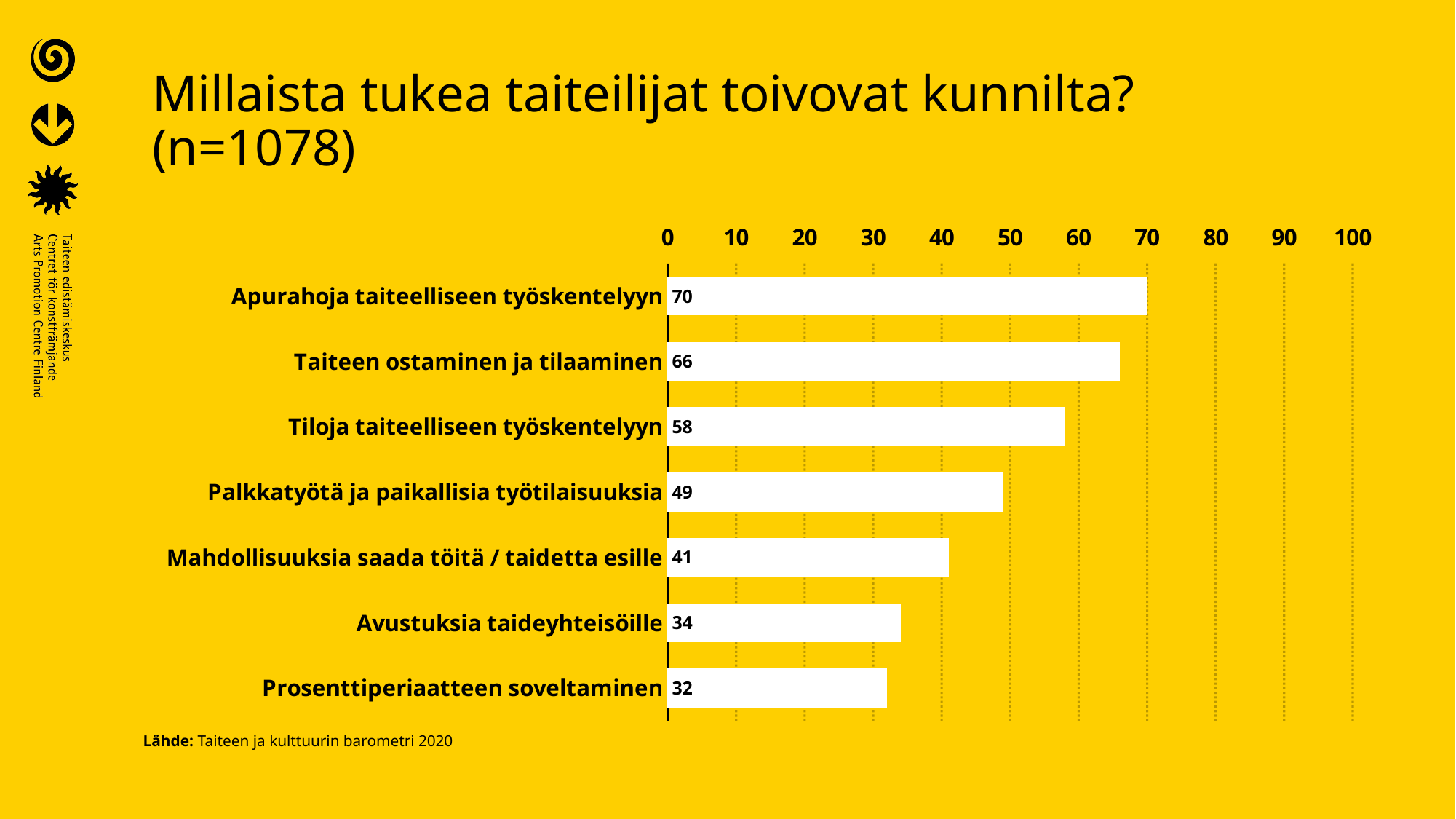
What is the value for "Avustuksia taideyhteisöille"? 34 Which category has the lowest value? Prosenttiperiaatteen soveltaminen What is the value for "Tiloja taiteelliseen työskentelyyn"? 58 Is the value for "Tiloja taiteelliseen työskentelyyn" greater or less than 50? greater What is the title of the slide? Millaista tukea taiteilijat toivovat kunnilta? (n=1078) What kind of chart is shown on the slide? bar chart What is the value for "Apurahoja taiteelliseen työskentelyyn"? 70 Which category has the highest value? Apurahoja taiteelliseen työskentelyyn What is the difference between the values for "Taiteen ostaminen ja tilaaminen" and "Palkkatyötä ja paikallisia työtilaisuuksia"? 17 How many categories are shown in the chart? 7 Which is larger, the value for "Mahdollisuuksia saada töitä / taidetta esille" or the value for "Avustuksia taideyhteisöille"? Mahdollisuuksia saada töitä / taidetta esille What is the highest value shown on the axis? 100